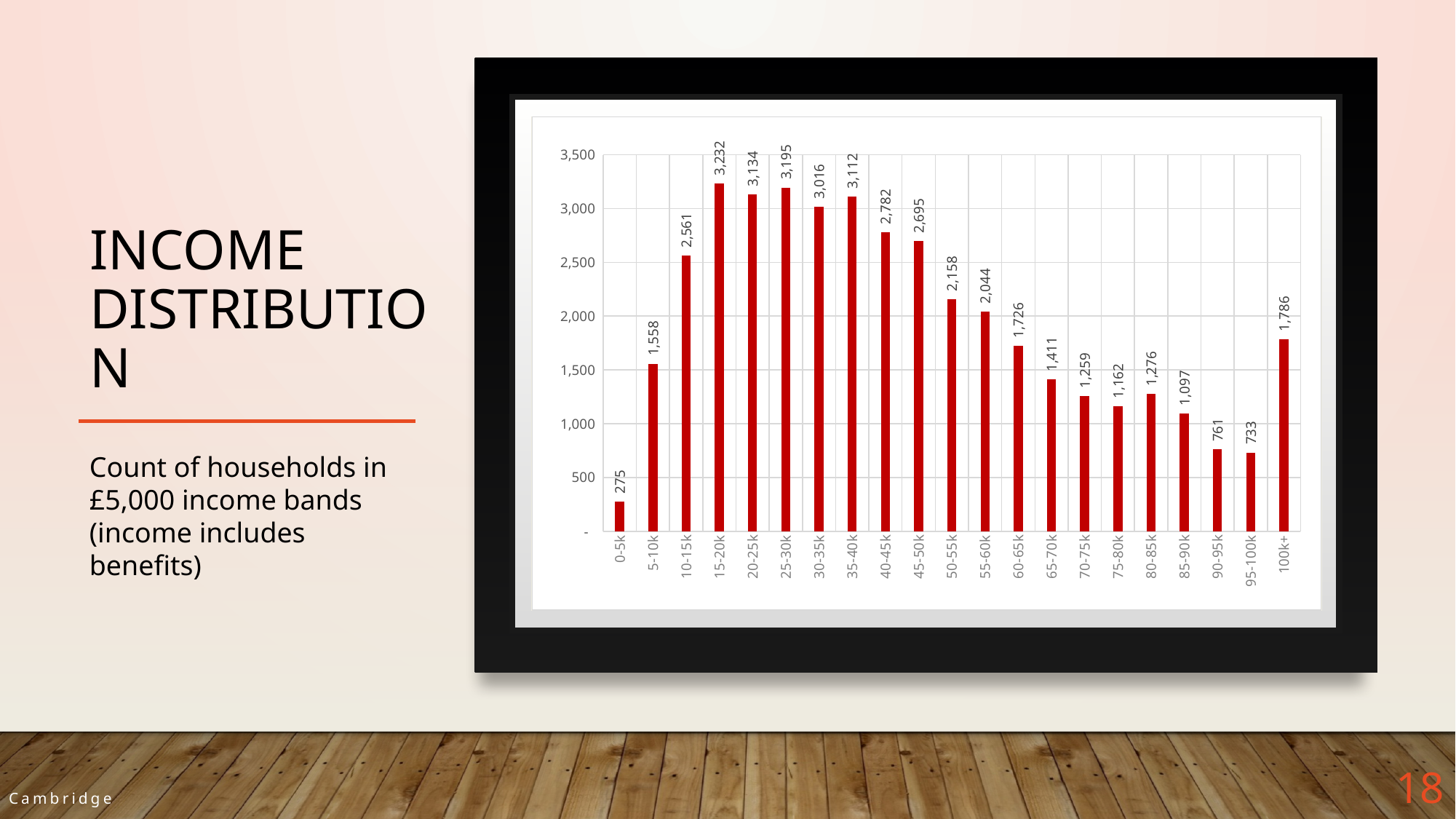
What is the count of households in the 0-5k income band? 275 How many income bands are plotted on the chart? 21 Which income band has the highest count of households? 15-20k Do the household counts rise or fall from the 45-50k band to the 75-80k band? fall What is the difference between the household counts for the 10-15k and 5-10k bands? 1,003 Which has more households, the 90-95k band or the 95-100k band? 90-95k What colour are the bars in the chart? red What is the count of households in the 100k+ income band? 1,786 Is the value for the 60-65k band greater or less than 1,500? greater What is the count of households in the 15-20k income band? 3,232 What kind of chart is shown on the slide? bar chart Which income band has the lowest count of households? 0-5k